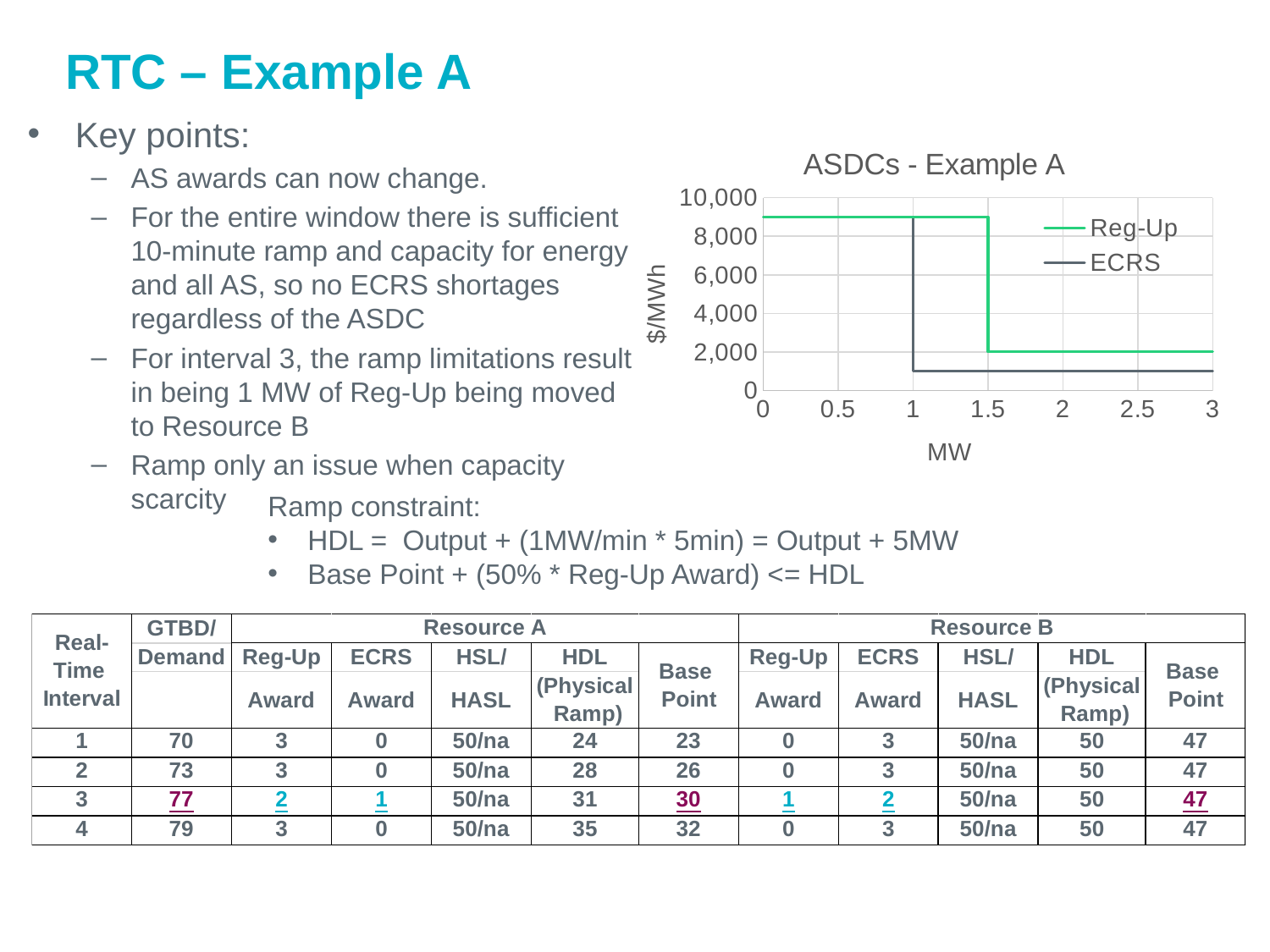
What is the title of the chart? ASDCs - Example A Do the ECRS values rise or fall as MW increases along the x axis? fall Is the Reg-Up value at 0.5 MW greater or less than 8,000 $/MWh? greater How many series does the chart's legend list? 2 At 2 MW, which series has the higher value, Reg-Up or ECRS? Reg-Up What kind of chart is shown on the slide? line chart Do the Reg-Up values rise or fall as MW increases along the x axis? fall Is the ECRS value at 0.5 MW greater or less than 6,000 $/MWh? greater Which series is drawn in green in the chart? Reg-Up Is the Reg-Up value at 2.5 MW greater or less than 4,000 $/MWh? less At 1.25 MW, which series has the higher value, Reg-Up or ECRS? Reg-Up